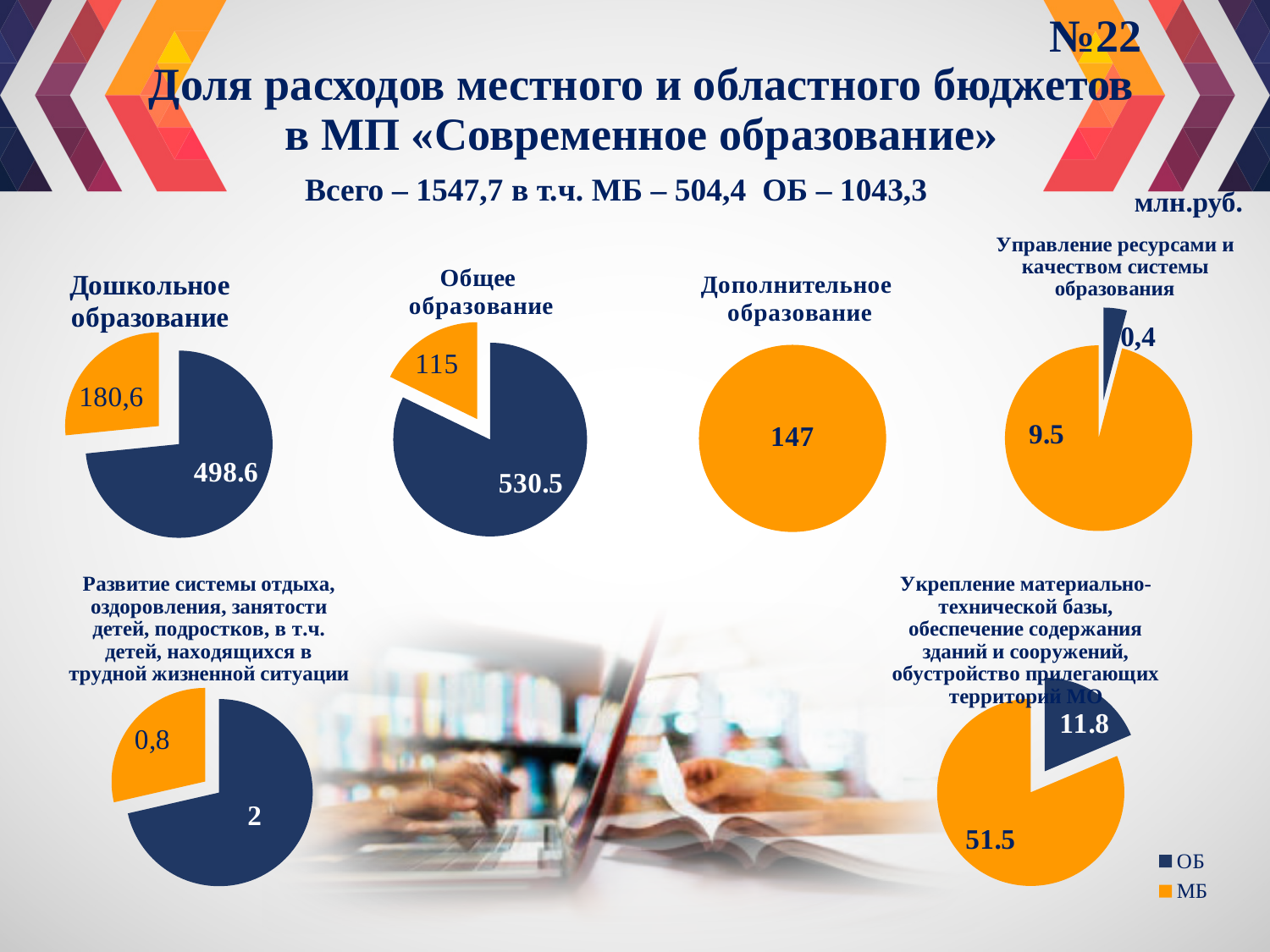
In the "Общее образование" pie chart, what is the value of the МБ slice? 115 In the "Дополнительное образование" pie chart, what value is shown? 147 How many series does the legend at the bottom right of the slide list? 2 In the "Дошкольное образование" pie chart, what is the value of the ОБ slice? 498.6 In the "Дошкольное образование" pie chart, what is the value of the МБ slice? 180,6 What type of chart is used for "Общее образование"? Pie chart In the "Развитие системы отдыха, оздоровления, занятости детей..." pie chart, what is the value of the ОБ slice? 2 In the "Укрепление материально-технической базы..." pie chart, which slice is larger, ОБ or МБ? МБ In the "Управление ресурсами и качеством системы образования" pie chart, which slice is larger, ОБ or МБ? МБ In the "Общее образование" pie chart, what is the value of the ОБ slice? 530.5 In the "Управление ресурсами и качеством системы образования" pie chart, what is the value of the ОБ slice? 0,4 In the "Укрепление материально-технической базы..." pie chart, what is the value of the МБ slice? 51.5